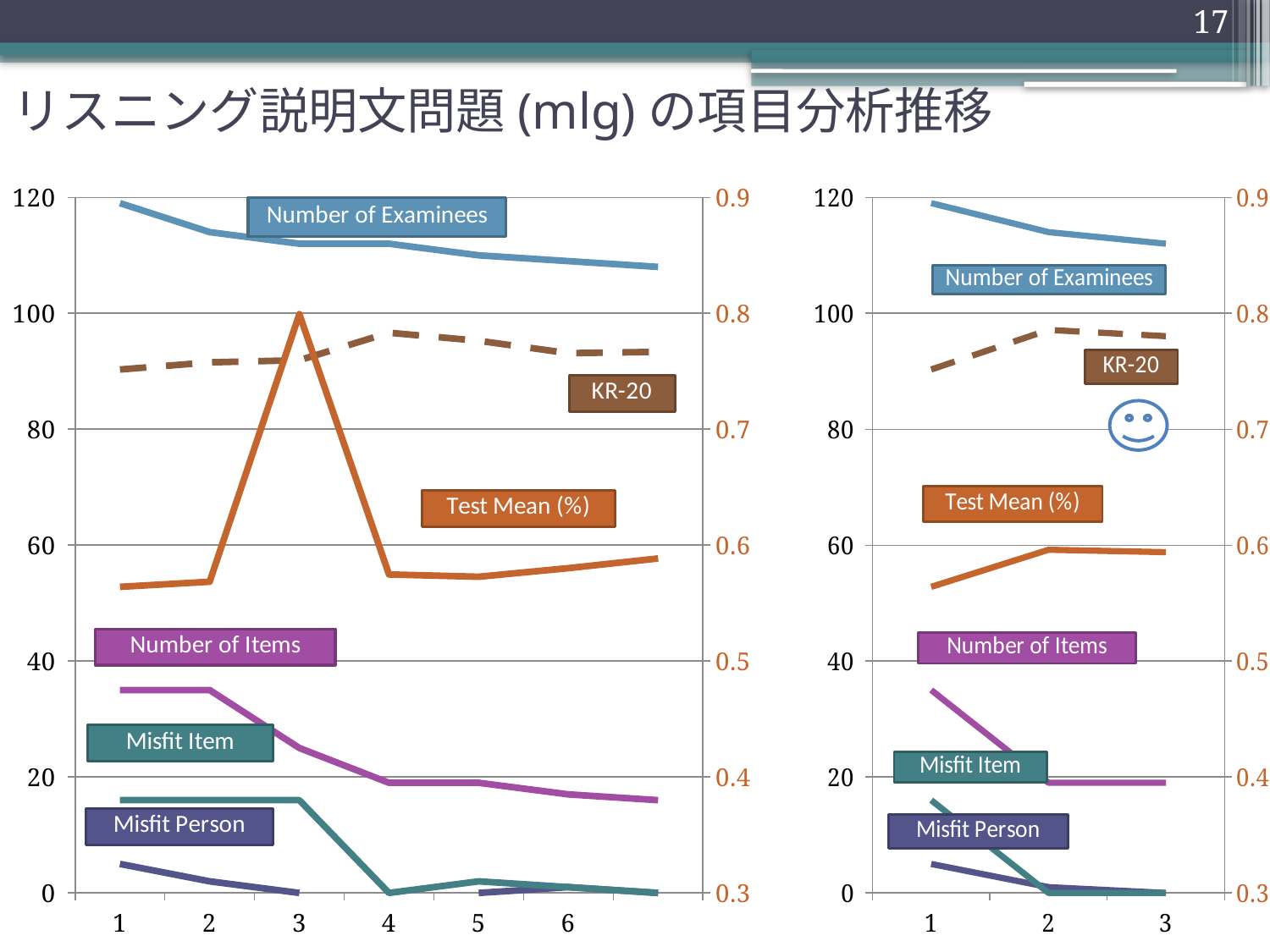
How many labelled series are shown in the right chart? 6 In the right chart, is the Test Mean (%) value at x = 1 greater or less than 60? less In the left chart, is the KR-20 value at x = 1 greater or less than 0.7 on the right-hand axis? greater In the right chart, is the Number of Examinees value at x = 1 greater or less than 100? greater In the left chart, at which x-axis value does the Test Mean (%) line reach its highest point? 3 In the left chart, does the Number of Items line rise or fall along the x axis? fall In the right chart, how many points are shown along the x axis? 3 What kind of chart is the left chart on the slide? line chart In the left chart at x = 1, which is larger: Number of Items or Misfit Item? Number of Items In the left chart, does the Number of Examinees line rise or fall along the x axis? fall